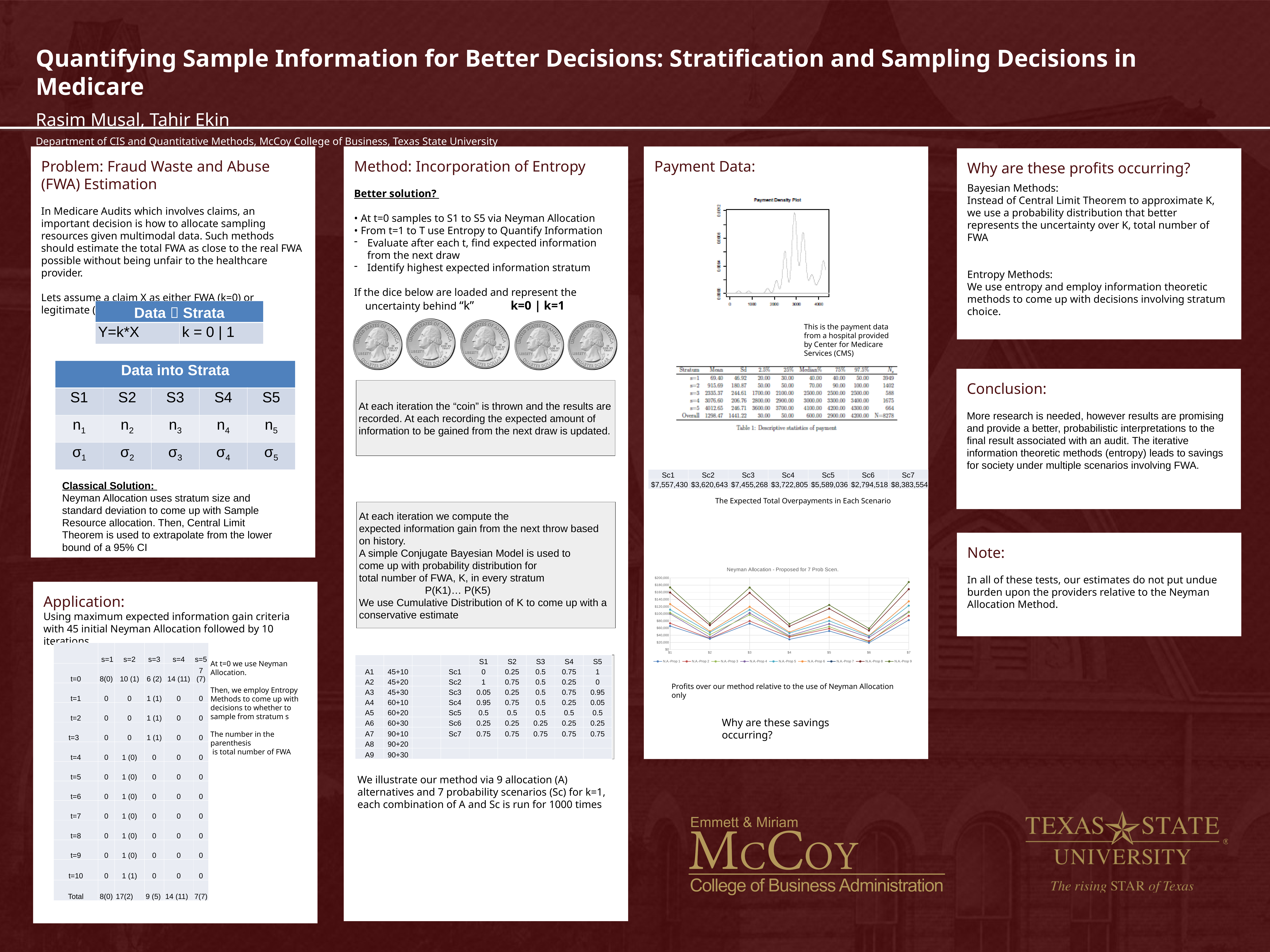
How many series does the legend of the 'Neyman Allocation - Proposed for 7 Prob Scen.' chart list? 9 In the 'Neyman Allocation - Proposed for 7 Prob Scen.' chart, do the values rise or fall from S1 to S2? fall What is the title of the chart at the top of the 'Payment Data' section? Payment Density Plot What kind of chart is the 'Payment Density Plot'? line chart In the 'Neyman Allocation - Proposed for 7 Prob Scen.' chart, at which scenario do the series reach their highest values? S7 In the 'Neyman Allocation - Proposed for 7 Prob Scen.' chart, is the highest value at S6 greater or less than $100,000? less In the 'Neyman Allocation - Proposed for 7 Prob Scen.' chart, is the highest value at S3 greater or less than $140,000? greater What kind of chart is the 'Neyman Allocation - Proposed for 7 Prob Scen.' chart? line chart In the 'Neyman Allocation - Proposed for 7 Prob Scen.' chart, do the values rise or fall from S6 to S7? rise What is the first series listed in the legend of the 'Neyman Allocation - Proposed for 7 Prob Scen.' chart? N.A.-Prop 1 How many scenarios are plotted along the x axis of the 'Neyman Allocation - Proposed for 7 Prob Scen.' chart? 7 In the 'Neyman Allocation - Proposed for 7 Prob Scen.' chart, is the highest value at S7 greater or less than $160,000? greater